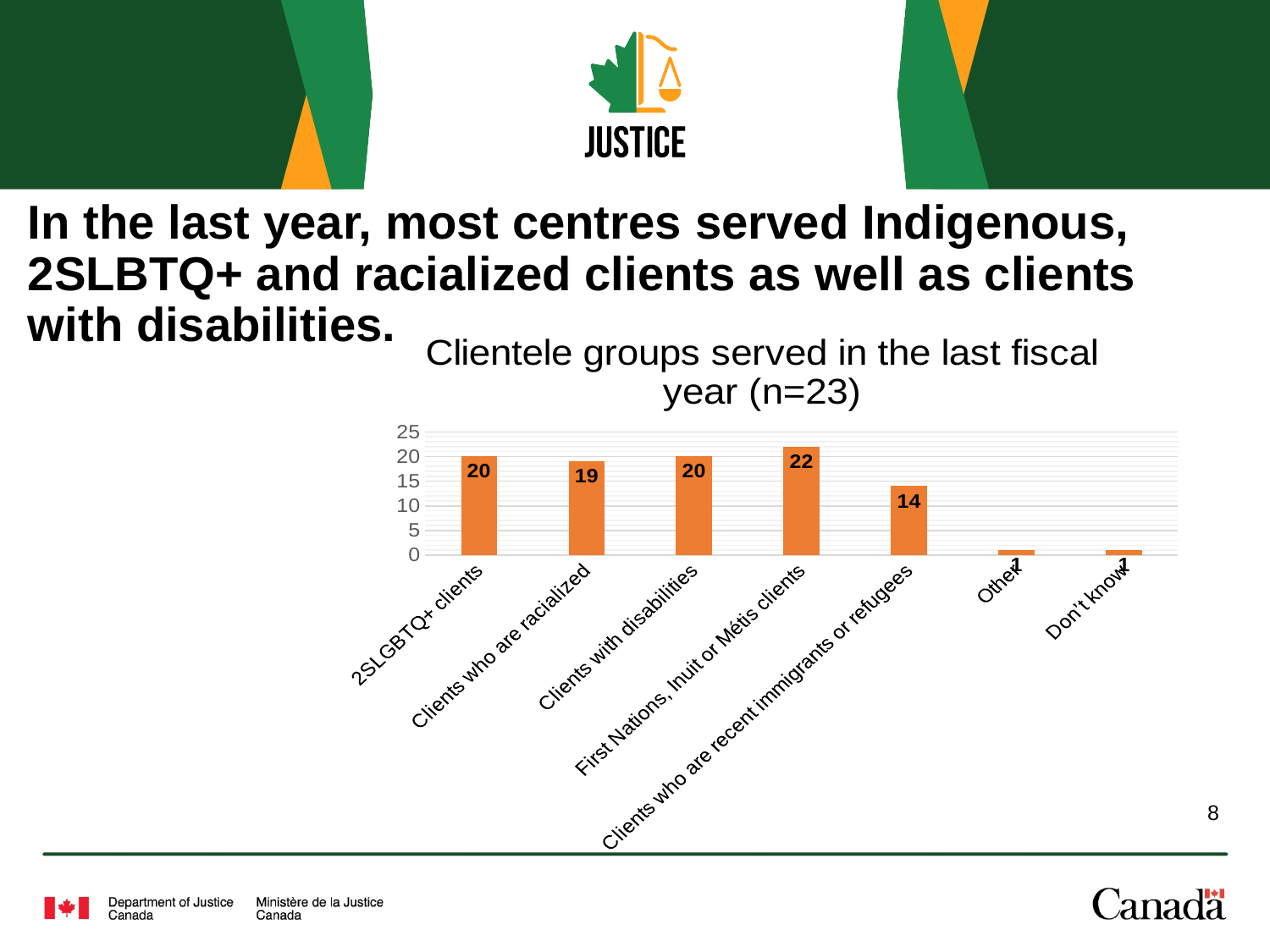
Which clientele group has the highest value? First Nations, Inuit or Métis clients Which is larger, the value for Clients who are recent immigrants or refugees or the value for Clients with disabilities? Clients with disabilities How many clientele groups are shown in the chart? 7 What kind of chart is shown on the slide? Bar chart What is the difference between the values for First Nations, Inuit or Métis clients and Clients who are recent immigrants or refugees? 8 What is the value for Clients who are recent immigrants or refugees? 14 What is the value for First Nations, Inuit or Métis clients? 22 What is the value for Clients who are racialized? 19 What is the value for 2SLGBTQ+ clients? 20 What is the title of the chart? Clientele groups served in the last fiscal year (n=23) What is the value for Other? 1 What is the difference between the values for Clients with disabilities and Clients who are racialized? 1